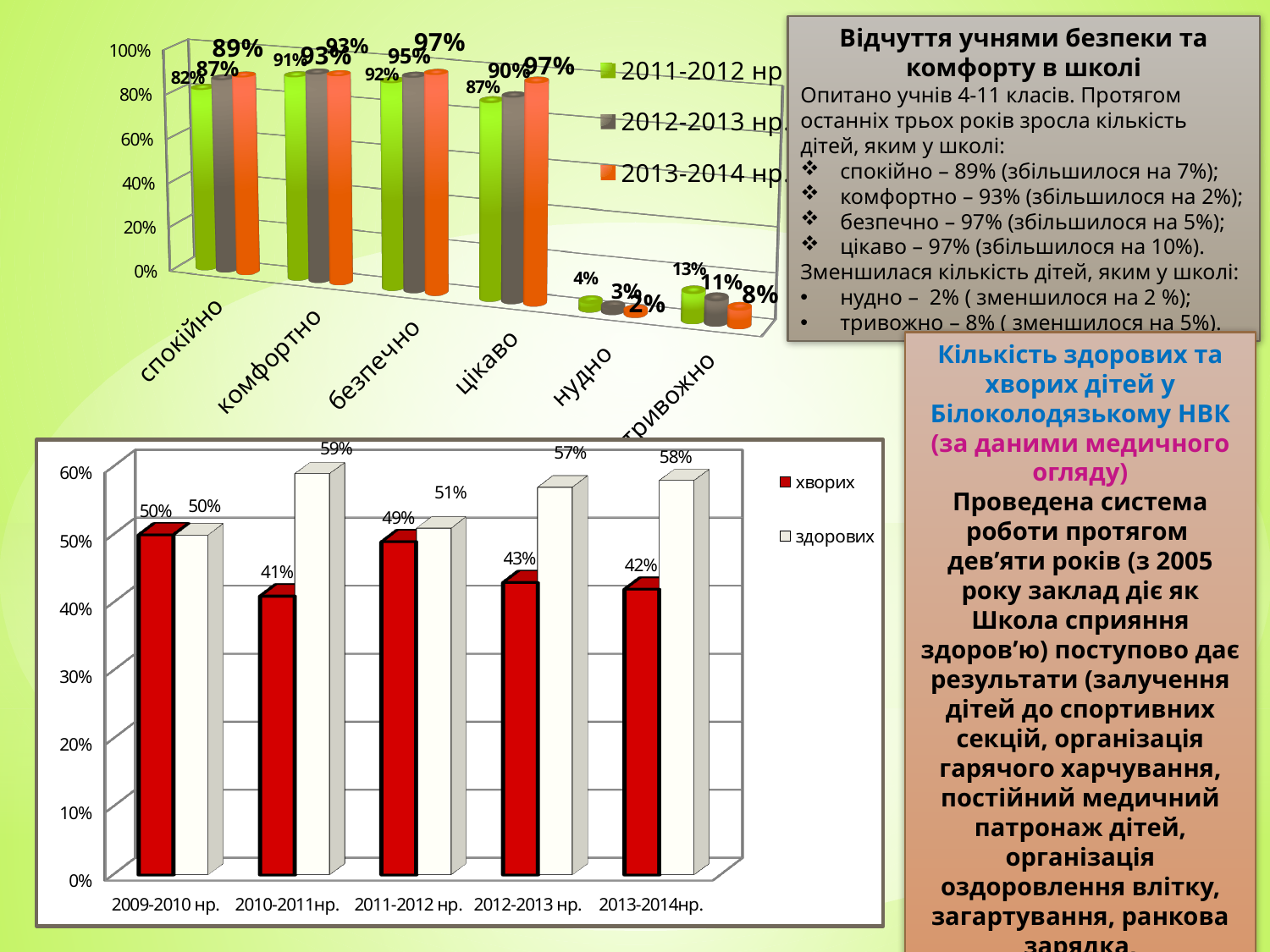
What kind of chart is the bottom chart? bar chart In the bottom chart, which year has the highest value for здорових? 2010-2011нр. In the top chart, how many series does the legend list? 3 In the bottom chart, what is the value for хворих in 2013-2014нр.? 42% In the top chart, what is the value for тривожно in the 2011-2012 нр series? 13% In the top chart, how many categories are shown on the x axis? 6 In the top chart, which category has the lowest value in the 2013-2014 нр series? нудно In the bottom chart, which is larger in 2012-2013 нр.: хворих or здорових? здорових In the bottom chart, what is the value for здорових in 2010-2011нр.? 59% In the bottom chart, what is the difference between здорових and хворих in 2013-2014нр.? 16% In the top chart, what is the difference between the 2013-2014 нр and 2011-2012 нр values for цікаво? 10% In the top chart, what is the value for спокійно in the 2013-2014 нр series? 89%